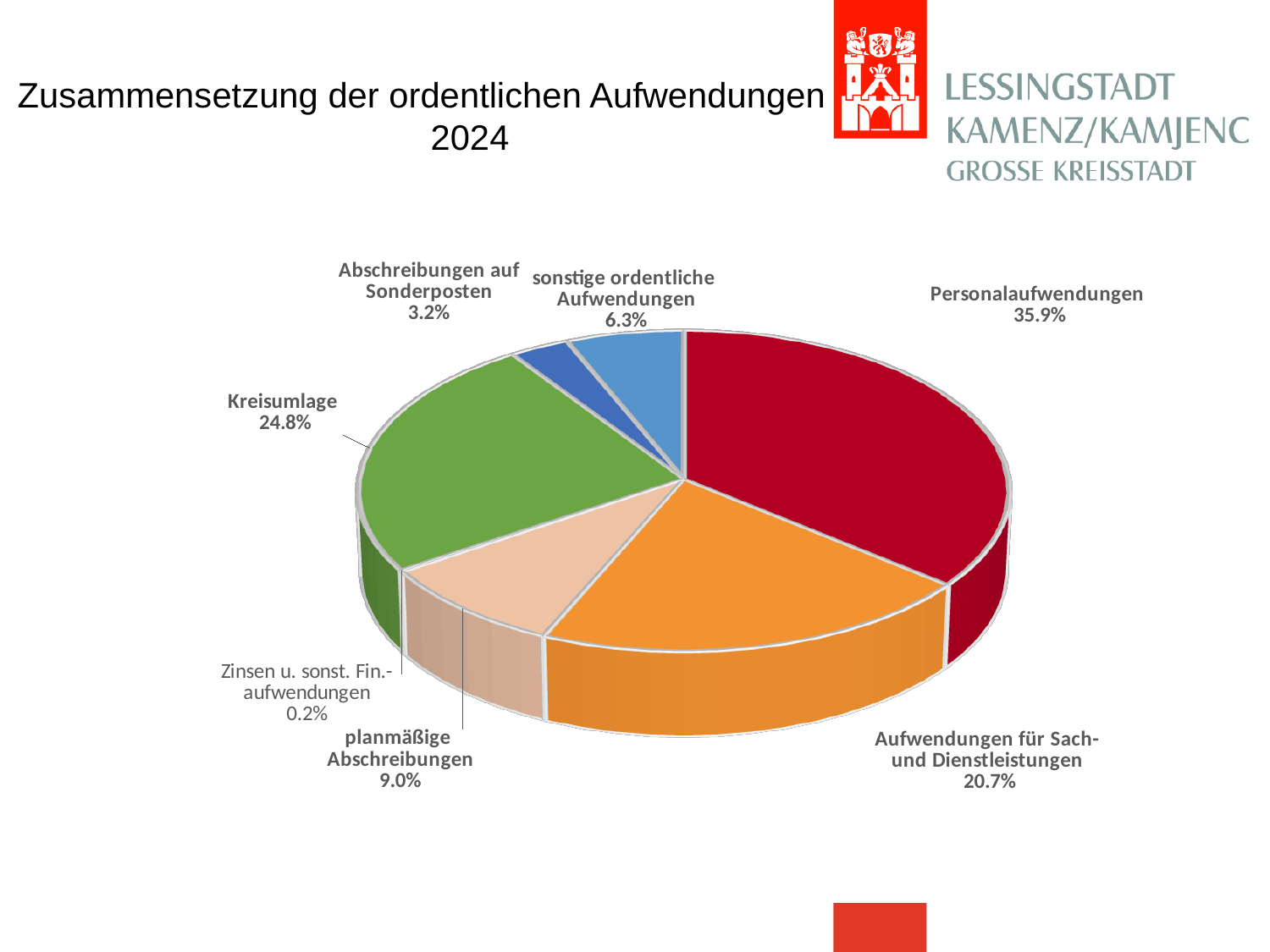
What is the value shown for Aufwendungen für Sach- und Dienstleistungen? 20.7% What kind of chart is shown on the slide? pie chart Which category has the smallest share of the pie? Zinsen u. sonst. Fin.-aufwendungen What is the difference between the shares of Personalaufwendungen and Kreisumlage? 11.1% What is the value shown for planmäßige Abschreibungen? 9.0% Which category has the largest share of the pie? Personalaufwendungen What is the title of the slide? Zusammensetzung der ordentlichen Aufwendungen 2024 Which is larger, sonstige ordentliche Aufwendungen or Abschreibungen auf Sonderposten? sonstige ordentliche Aufwendungen What is the value shown for Kreisumlage? 24.8% What share of the pie does Personalaufwendungen have? 35.9% How many slices does the pie chart have? 7 What is the value shown for Zinsen u. sonst. Fin.-aufwendungen? 0.2%